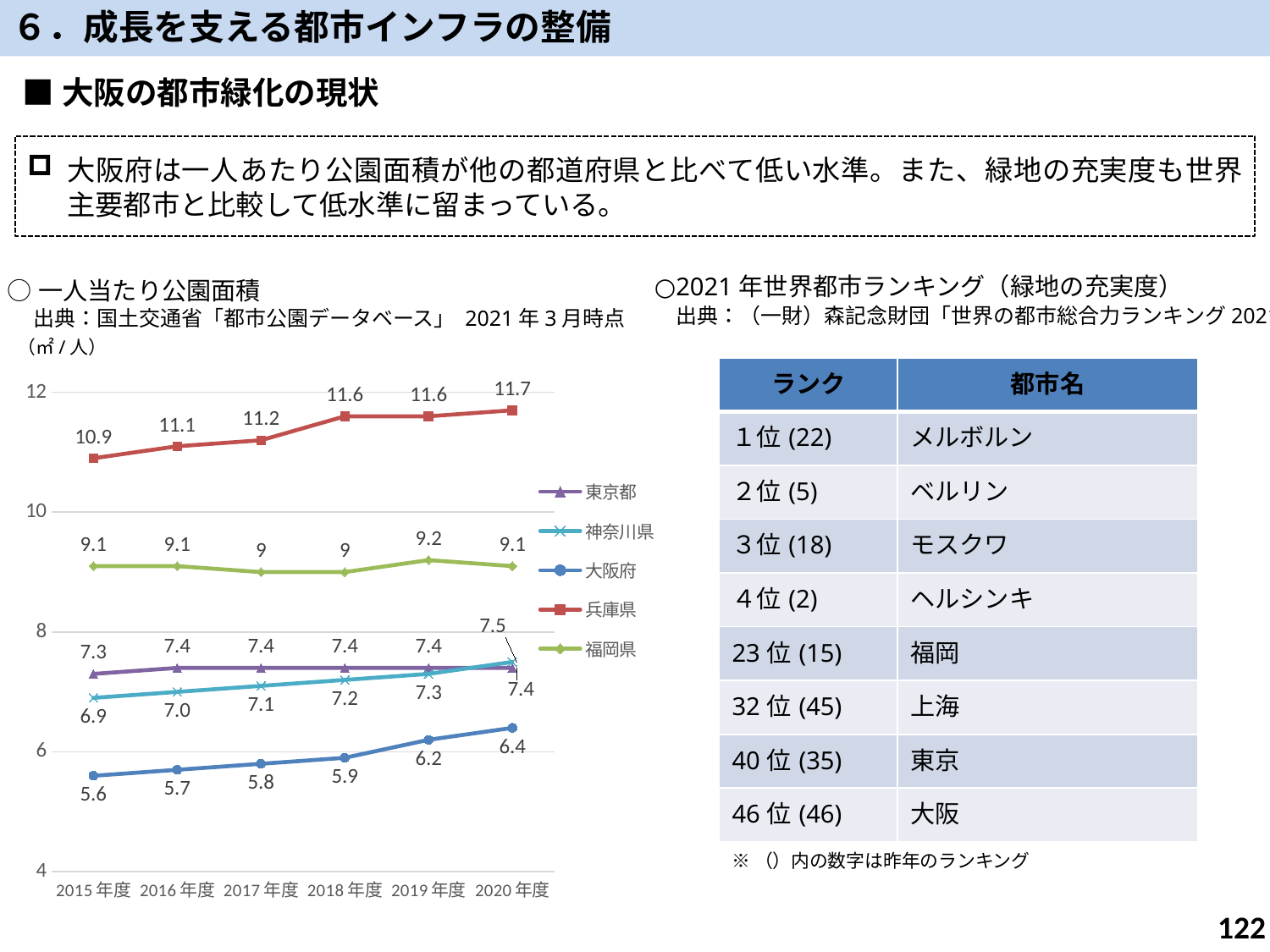
What is the value for 兵庫県 in 2015年度 in the 一人当たり公園面積 chart? 10.9 How many fiscal years are plotted on the x axis of the 一人当たり公園面積 chart? 6 In 2018年度, which is larger in the 一人当たり公園面積 chart: 福岡県 or 東京都? 福岡県 What kind of chart is the 一人当たり公園面積 chart? line chart Which prefecture has the lowest value in 2015年度 in the 一人当たり公園面積 chart? 大阪府 What is the difference between 兵庫県 and 大阪府 in 2020年度 in the 一人当たり公園面積 chart? 5.3 Which prefecture has the highest value in 2020年度 in the 一人当たり公園面積 chart? 兵庫県 What unit is shown above the y axis of the 一人当たり公園面積 chart? ㎡/人 Does the value for 大阪府 rise or fall from 2015年度 to 2020年度 in the 一人当たり公園面積 chart? rise What is the value for 神奈川県 in 2019年度 in the 一人当たり公園面積 chart? 7.3 What is the value for 大阪府 in 2020年度 in the 一人当たり公園面積 chart? 6.4 How many series does the legend of the 一人当たり公園面積 chart list? 5